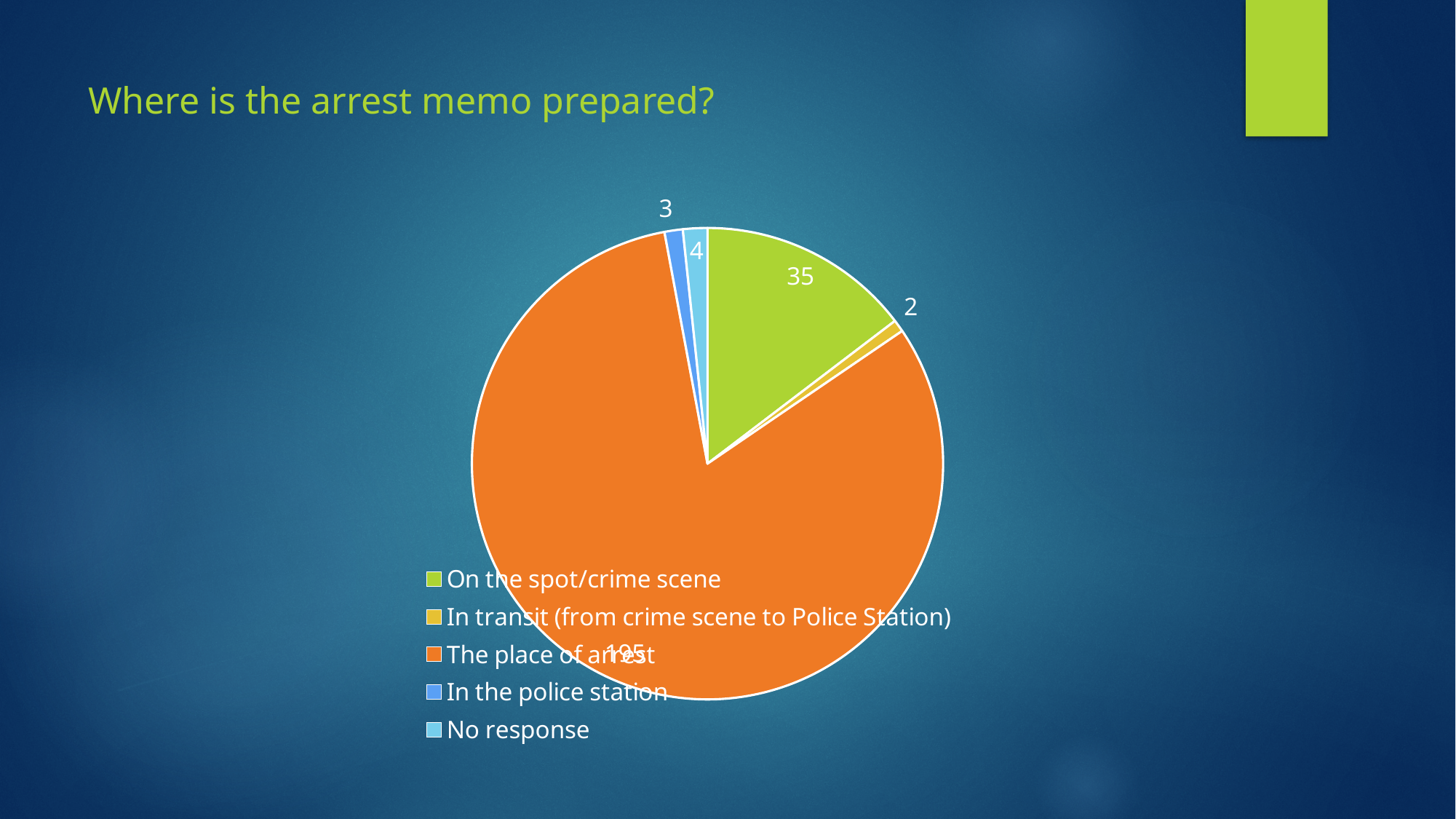
Which is larger: the value for 'On the spot/crime scene' or the value for 'No response'? On the spot/crime scene What value is shown for the 'On the spot/crime scene' slice? 35 What value is shown for the 'In the police station' slice? 3 What value is shown for the 'No response' slice? 4 Which category has the smallest slice of the pie? In transit (from crime scene to Police Station) What is the difference between the values for 'No response' and 'In the police station'? 1 What value is shown for the 'In transit (from crime scene to Police Station)' slice? 2 What is the difference between the values for 'On the spot/crime scene' and 'In transit (from crime scene to Police Station)'? 33 What kind of chart is shown on the slide? Pie chart What is the title of the slide? Where is the arrest memo prepared? How many categories does the pie chart show? 5 Which category has the largest slice of the pie? The place of arrest